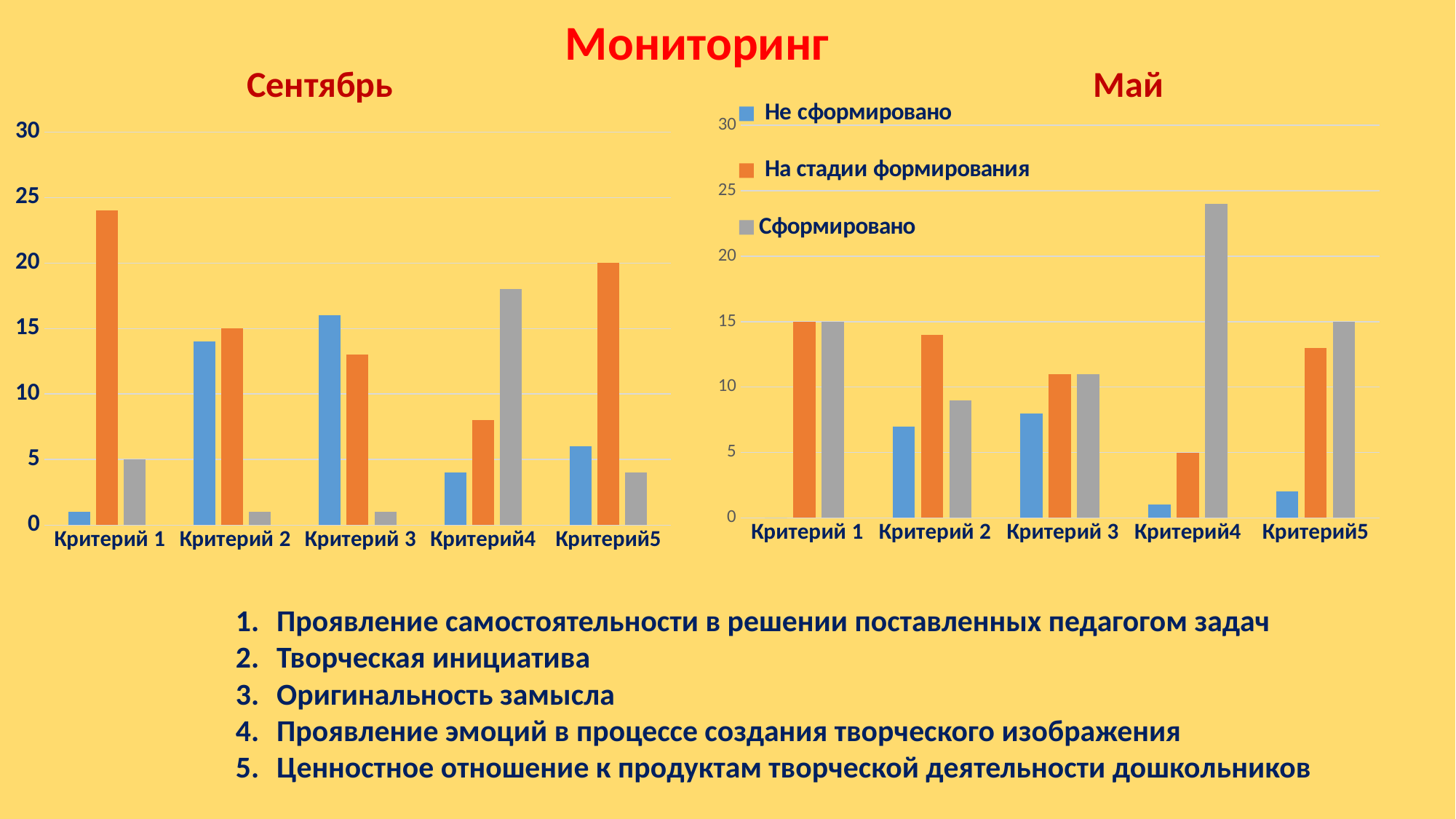
In the "Сентябрь" chart, what is the value of "Сформировано" for Критерий 1? 5 Which series is shown in orange in the legend of the "Май" chart? На стадии формирования In the "Сентябрь" chart, for Критерий4, which is larger: "Сформировано" or "На стадии формирования"? Сформировано In the "Май" chart, which category has the highest "Сформировано" value? Критерий4 How many series does the legend on the "Май" chart list? 3 In the "Май" chart, is the value of "Сформировано" for Критерий4 greater or less than 20? greater How many categories are shown on the x axis of the "Май" chart? 5 In the "Май" chart, what is the value of "На стадии формирования" for Критерий4? 5 What kind of chart is the "Сентябрь" chart? bar chart In the "Сентябрь" chart, which category has the highest "На стадии формирования" value? Критерий 1 In the "Май" chart, what is the value of "На стадии формирования" for Критерий 1? 15 In the "Сентябрь" chart, is the value of "На стадии формирования" for Критерий 1 greater or less than 20? greater